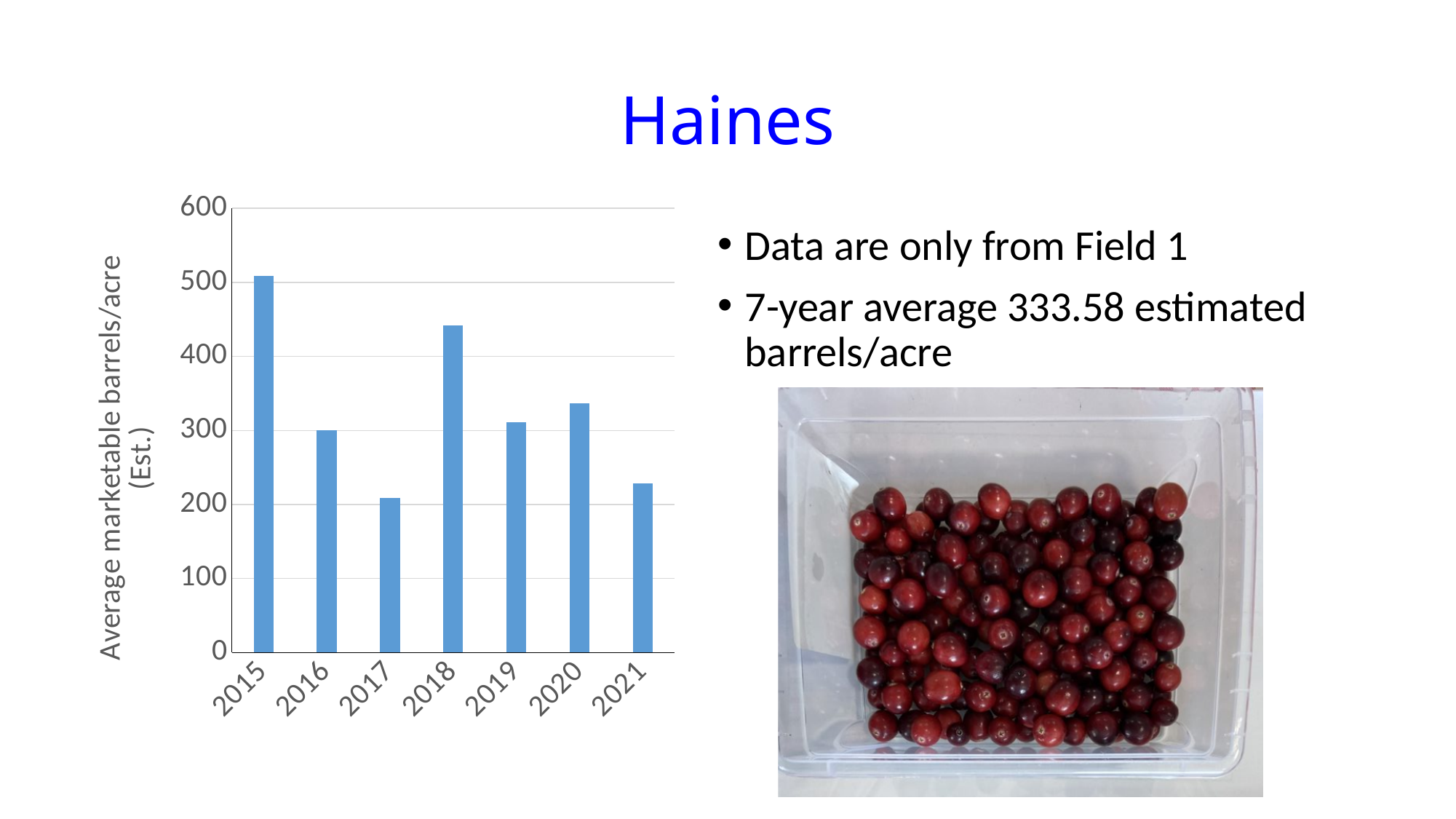
Which year has the larger value, 2018 or 2016? 2018 Which year has the highest average marketable barrels/acre? 2015 Does the value rise or fall from 2015 to 2016? fall What is the label on the vertical axis of the chart? Average marketable barrels/acre (Est.) Is the value for 2018 greater or less than 400? greater Which year has the lowest average marketable barrels/acre? 2017 Is the value for 2015 greater or less than 400? greater Which year has the larger value, 2020 or 2021? 2020 Is the value for 2021 greater or less than 300? less How many years are plotted on the chart? 7 What kind of chart is shown on the slide? bar chart